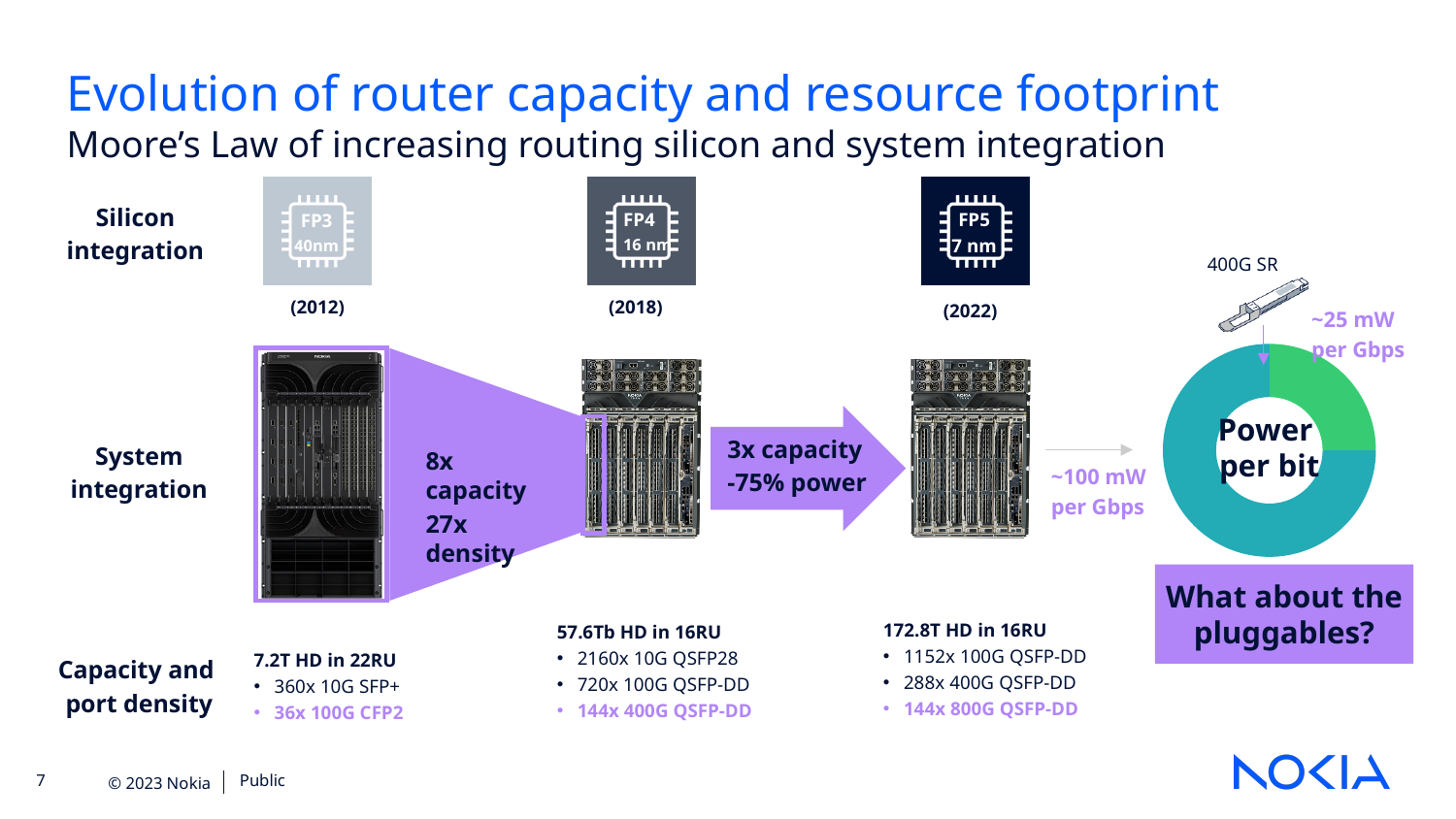
What is the title printed in the centre of the donut chart? Power per bit In the "Power per bit" donut chart, which component accounts for the largest slice? The router (~100 mW per Gbps) Is the green slice of the "Power per bit" donut chart more or less than half of the donut? Less How many slices does the "Power per bit" donut chart have? 2 In the "Power per bit" donut chart, which component accounts for the smallest slice? The 400G SR pluggable (~25 mW per Gbps) What colour is the slice of the "Power per bit" donut chart that represents the 400G SR pluggable? Green What kind of chart is the "Power per bit" chart on the right of the slide? Donut (pie) chart In the "Power per bit" donut chart, which slice is larger: the teal slice (router, ~100 mW per Gbps) or the green slice (400G SR pluggable, ~25 mW per Gbps)? The teal slice (router, ~100 mW per Gbps)